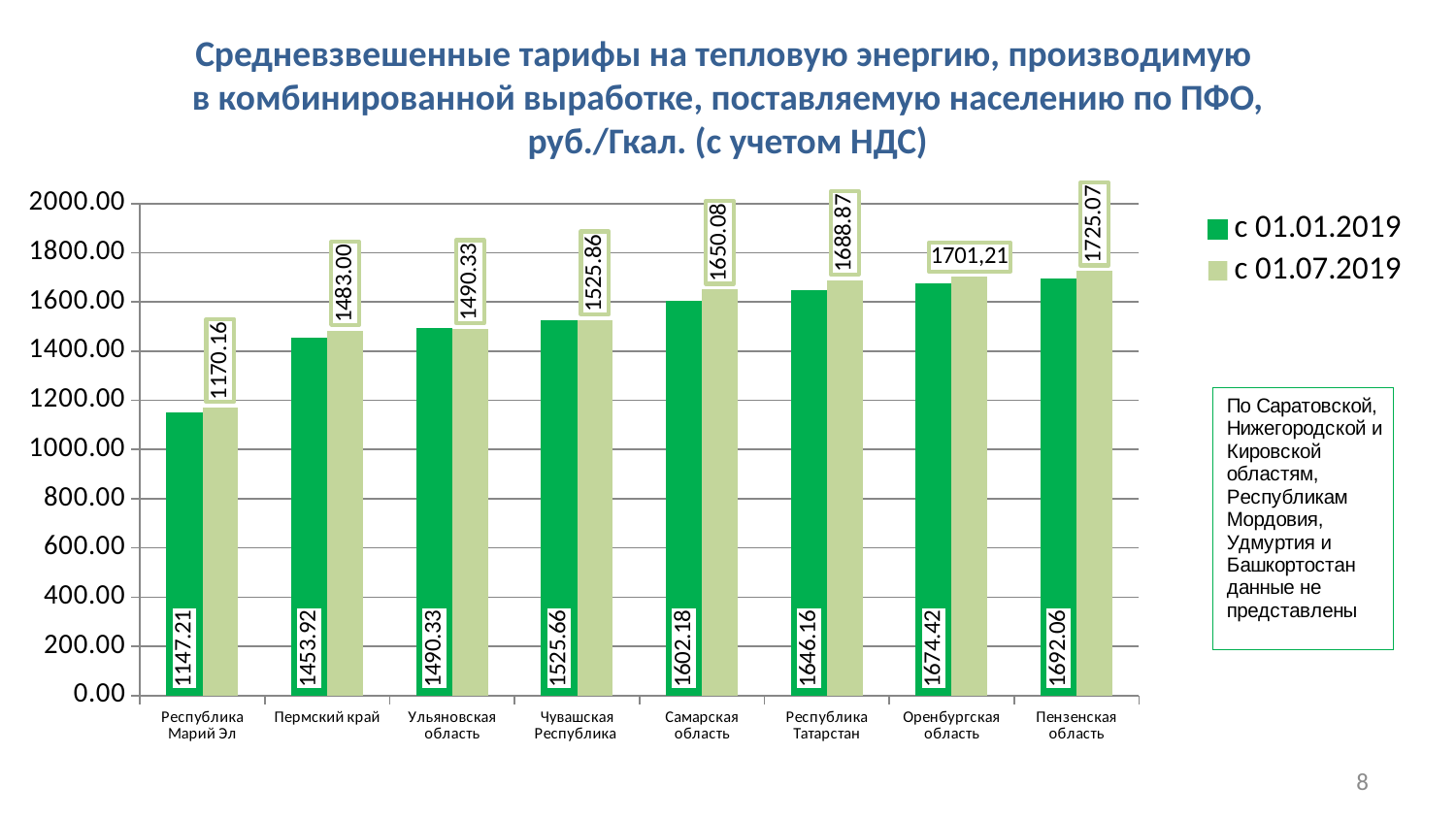
How many series does the legend list? 2 Which is larger for Пермский край: the value for 'с 01.01.2019' or for 'с 01.07.2019'? с 01.07.2019 Which region has the highest value in the series 'с 01.07.2019'? Пензенская область What is the difference between the 'с 01.07.2019' and 'с 01.01.2019' values for Республика Татарстан? 42.71 What is the value for Пензенская область in the series 'с 01.07.2019'? 1725.07 What kind of chart is shown on the slide? bar chart What is the value for Самарская область in the series 'с 01.07.2019'? 1650.08 How many regions are shown on the x axis of the chart? 8 Is the value for Республика Марий Эл in the series 'с 01.07.2019' greater or less than 1200.00? less Do the values in the series 'с 01.01.2019' rise or fall from left to right along the x axis? rise Which region has the lowest value in the series 'с 01.01.2019'? Республика Марий Эл What is the value for Республика Марий Эл in the series 'с 01.01.2019'? 1147.21